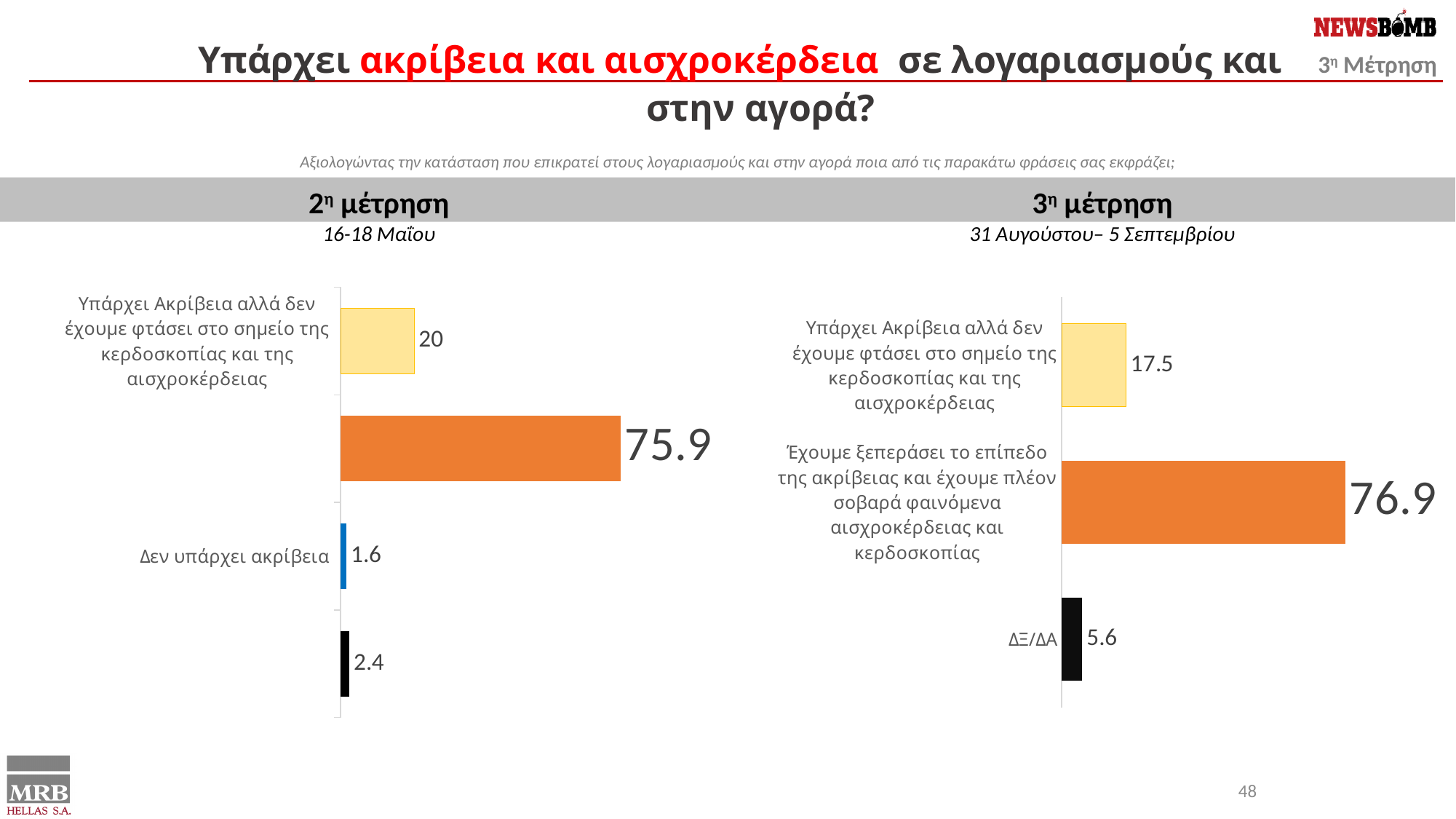
How many bars are plotted in the right chart (3η μέτρηση)? 3 In the left chart (2η μέτρηση), what is the value for 'Υπάρχει Ακρίβεια αλλά δεν έχουμε φτάσει στο σημείο της κερδοσκοπίας και της αισχροκέρδειας'? 20 In the right chart (3η μέτρηση), what is the difference between the value for 'Έχουμε ξεπεράσει το επίπεδο της ακρίβειας...' and the value for 'Υπάρχει Ακρίβεια αλλά δεν έχουμε φτάσει...'? 59.4 In the left chart (2η μέτρηση), what is the smallest value shown? 1.6 Which is larger: the value for 'Υπάρχει Ακρίβεια αλλά δεν έχουμε φτάσει...' in the left chart (2η μέτρηση) or in the right chart (3η μέτρηση)? Left chart (2η μέτρηση), 20 In the right chart (3η μέτρηση), what is the value for 'Υπάρχει Ακρίβεια αλλά δεν έχουμε φτάσει στο σημείο της κερδοσκοπίας και της αισχροκέρδειας'? 17.5 In the right chart (3η μέτρηση), what is the value for 'ΔΞ/ΔΑ'? 5.6 In the left chart (2η μέτρηση), what is the value for 'Δεν υπάρχει ακρίβεια'? 1.6 What type of chart is used for the 2η μέτρηση data on the left? Bar chart In the left chart (2η μέτρηση), what is the largest value shown? 75.9 In the right chart (3η μέτρηση), which category has the lowest value? ΔΞ/ΔΑ In the right chart (3η μέτρηση), what is the value for 'Έχουμε ξεπεράσει το επίπεδο της ακρίβειας και έχουμε πλέον σοβαρά φαινόμενα αισχροκέρδειας και κερδοσκοπίας'? 76.9